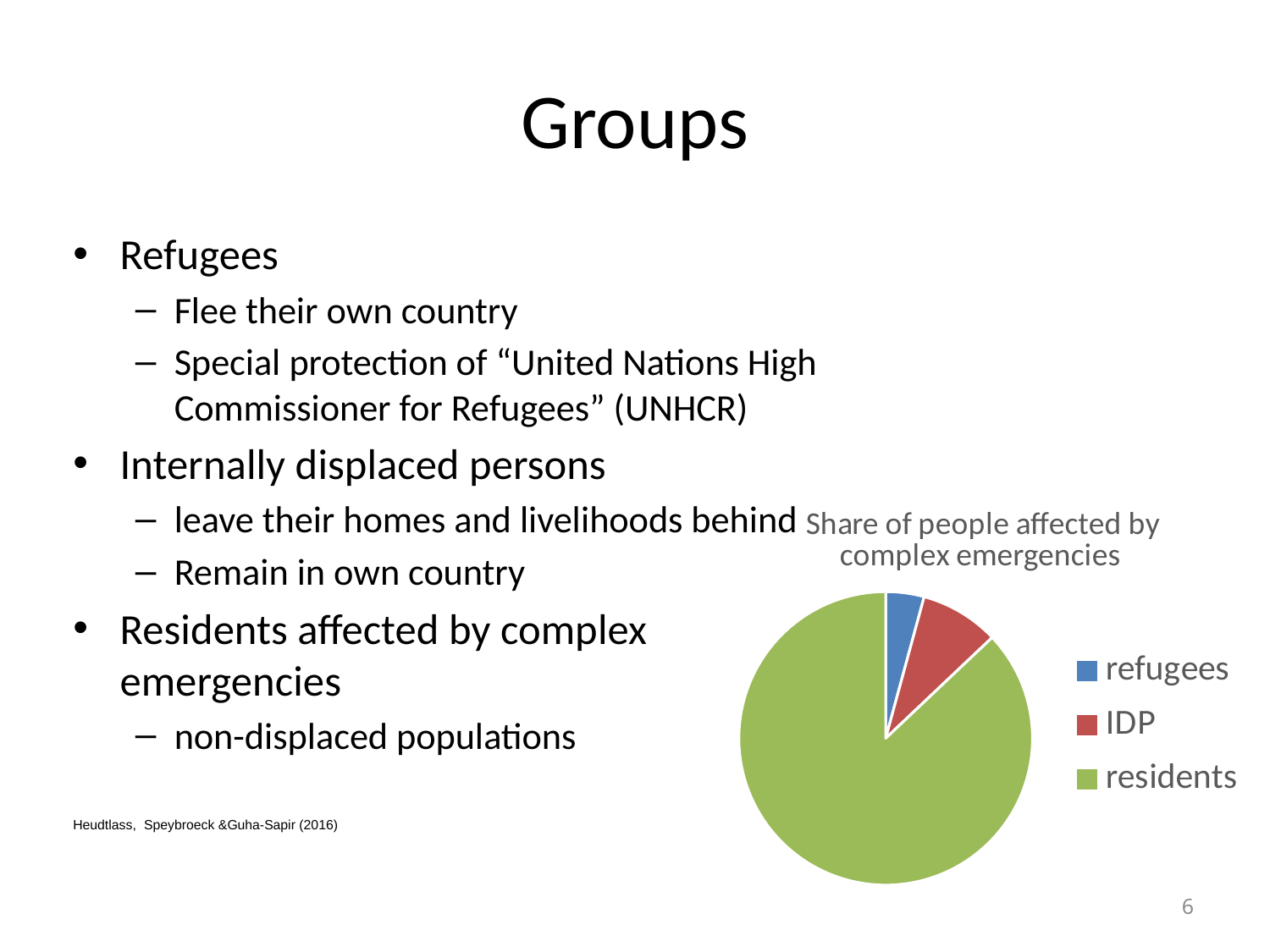
How many entries does the legend of the pie chart list? 3 What colour is the residents slice in the pie chart? green Which group has the smallest share in the pie chart? refugees How many slices does the pie chart have? 3 Which legend entry is shown in red in the pie chart? IDP Which slice is larger in the pie chart, IDP or refugees? IDP Which slice is larger in the pie chart, residents or IDP? residents What is the title of the pie chart? Share of people affected by complex emergencies Which group has the largest share in the pie chart? residents What kind of chart is shown on the slide? pie chart